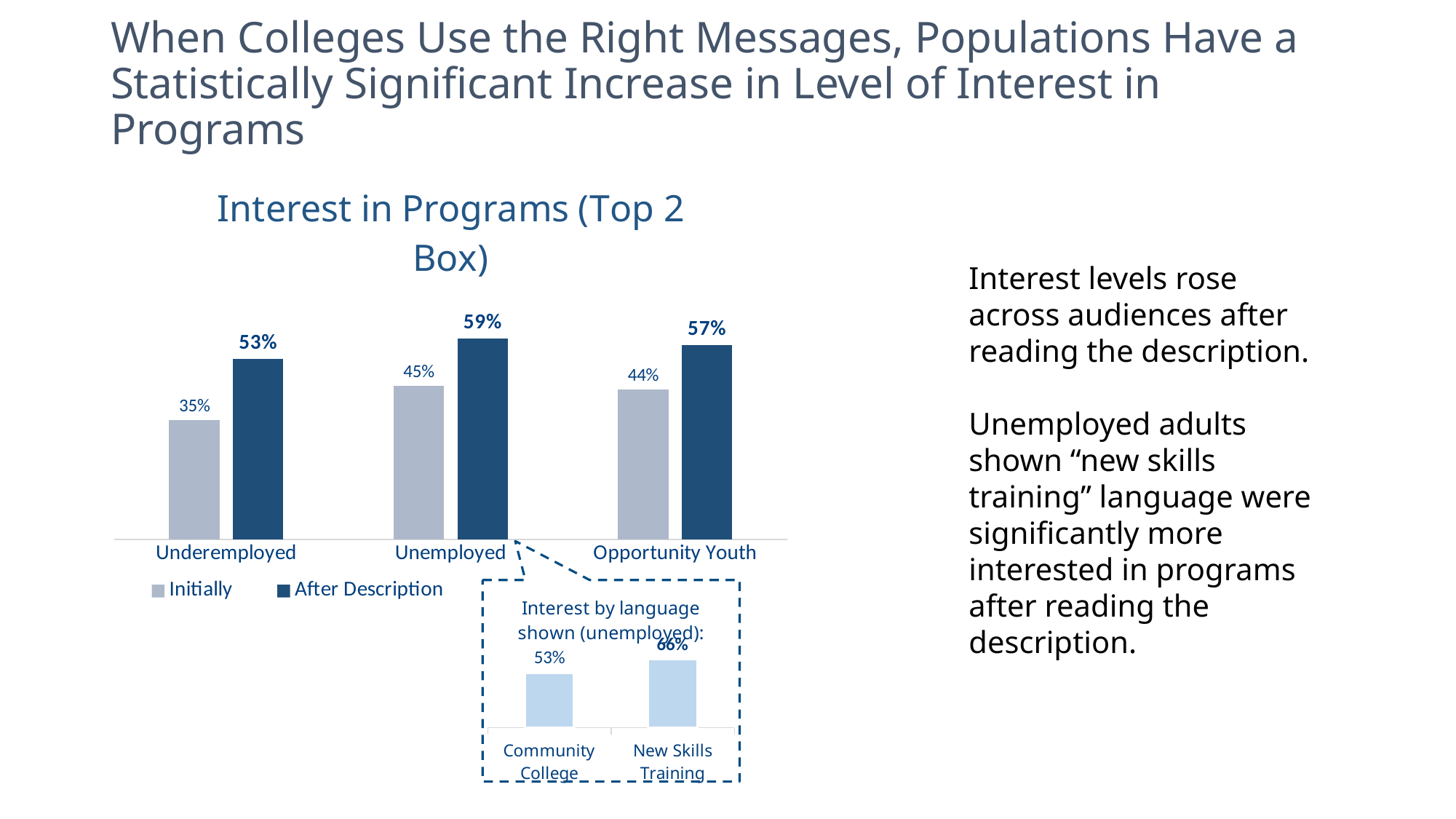
In the 'Interest in Programs (Top 2 Box)' chart, which category has the lowest 'Initially' value? Underemployed In the 'Interest in Programs (Top 2 Box)' chart, what is the 'After Description' value for Unemployed? 59% In the 'Interest in Programs (Top 2 Box)' chart, which category has the highest 'After Description' value? Unemployed In the 'Interest in Programs (Top 2 Box)' chart, which is larger: the 'Initially' value for Unemployed or the 'Initially' value for Opportunity Youth? Unemployed In the 'Interest in Programs (Top 2 Box)' chart, what is the difference between the 'After Description' and 'Initially' values for Underemployed? 18% In the 'Interest by language shown (unemployed)' chart, what is the difference between New Skills Training and Community College? 13% In the 'Interest in Programs (Top 2 Box)' chart, what is the 'Initially' value for Underemployed? 35% In the 'Interest in Programs (Top 2 Box)' chart, what is the 'Initially' value for Opportunity Youth? 44% How many series does the legend of the 'Interest in Programs (Top 2 Box)' chart list? 2 In the 'Interest by language shown (unemployed)' chart, what is the value for New Skills Training? 66% How many categories are shown on the x axis of the 'Interest in Programs (Top 2 Box)' chart? 3 What kind of chart is the 'Interest in Programs (Top 2 Box)' chart? Bar chart